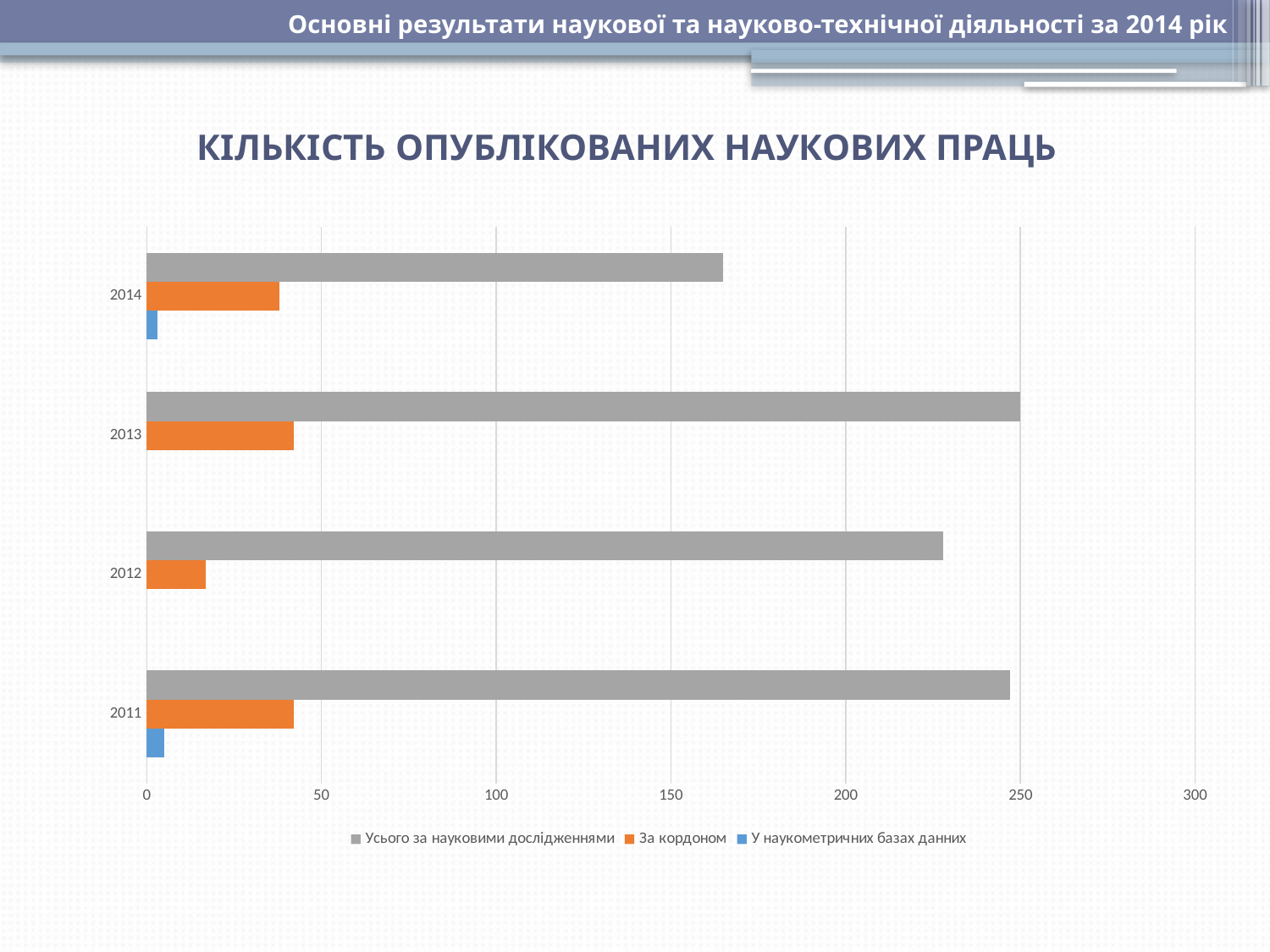
How many years are shown on the chart? 4 Is the value for 'Усього за науковими дослідженнями' in 2014 greater or less than 150? greater Which is larger: 'Усього за науковими дослідженнями' in 2012 or in 2014? 2012 Which series is shown in orange? За кордоном What is the title of the chart? КІЛЬКІСТЬ ОПУБЛІКОВАНИХ НАУКОВИХ ПРАЦЬ Is the value for 'За кордоном' in 2014 greater or less than 50? less How many series does the legend list? 3 Which is larger: 'За кордоном' in 2013 or in 2012? 2013 Which year has the lowest value for 'Усього за науковими дослідженнями'? 2014 Is the value for 'Усього за науковими дослідженнями' in 2012 greater or less than 200? greater Which year has the lowest value for 'За кордоном'? 2012 What kind of chart is shown on the slide? bar chart